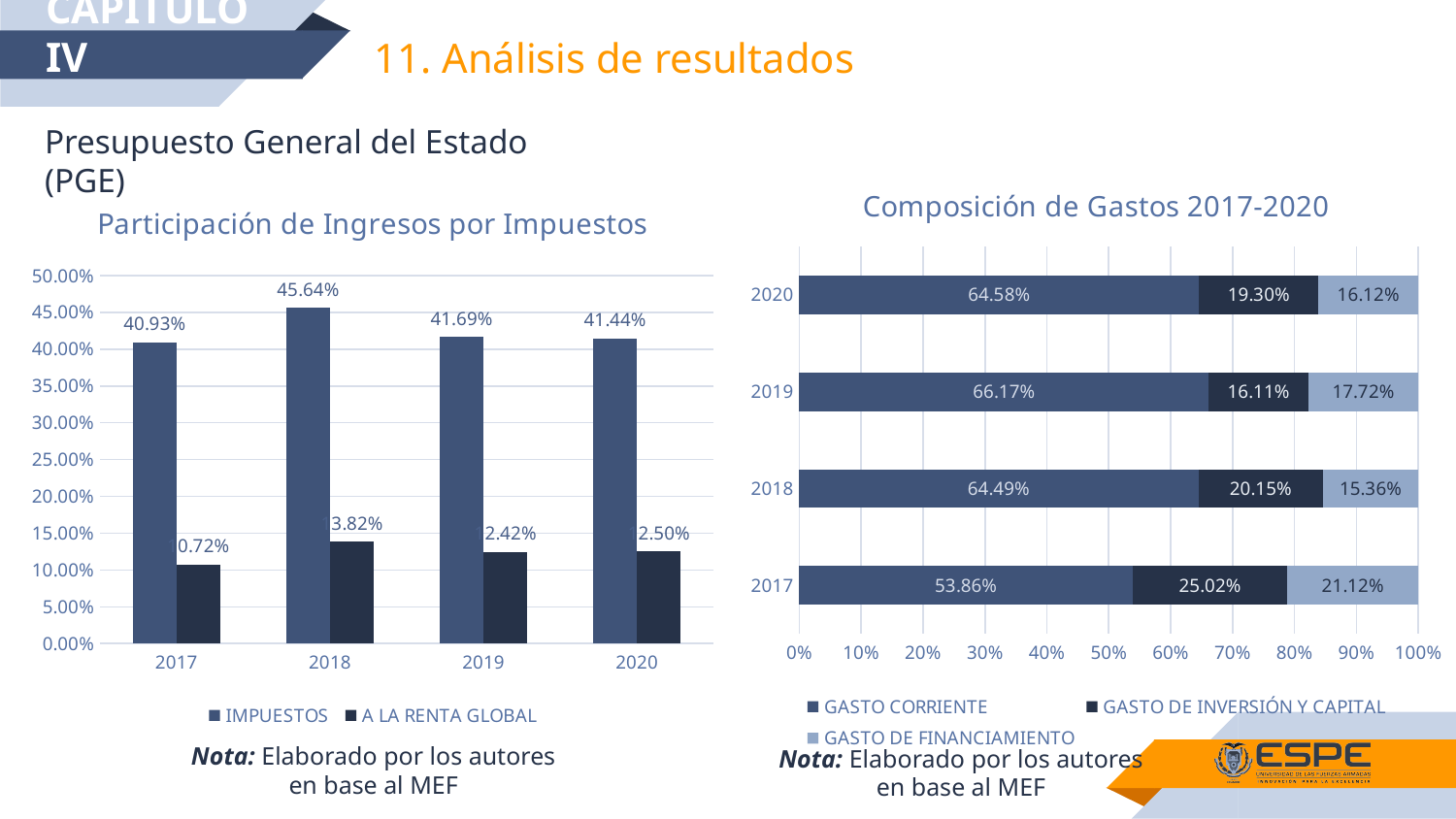
In the chart 'Participación de Ingresos por Impuestos', which year has the highest IMPUESTOS value? 2018 In the chart 'Composición de Gastos 2017-2020', which year has the lowest GASTO CORRIENTE value? 2017 What kind of chart is 'Composición de Gastos 2017-2020'? Stacked bar chart In the chart 'Participación de Ingresos por Impuestos', what is the difference between the IMPUESTOS values for 2018 and 2017? 4.71% In the chart 'Composición de Gastos 2017-2020', what is the GASTO CORRIENTE value for 2019? 66.17% How many series does the legend of the chart 'Composición de Gastos 2017-2020' list? 3 In the chart 'Composición de Gastos 2017-2020', what is the GASTO DE FINANCIAMIENTO value for 2017? 21.12% In the chart 'Participación de Ingresos por Impuestos', what is the IMPUESTOS value for 2018? 45.64% In the chart 'Participación de Ingresos por Impuestos', is the A LA RENTA GLOBAL value for 2017 greater or less than 15.00%? less How many series does the legend of the chart 'Participación de Ingresos por Impuestos' list? 2 In the chart 'Composición de Gastos 2017-2020', which year has the highest GASTO DE INVERSIÓN Y CAPITAL value? 2017 In the chart 'Composición de Gastos 2017-2020', for 2020, which is larger: GASTO DE INVERSIÓN Y CAPITAL or GASTO DE FINANCIAMIENTO? GASTO DE INVERSIÓN Y CAPITAL